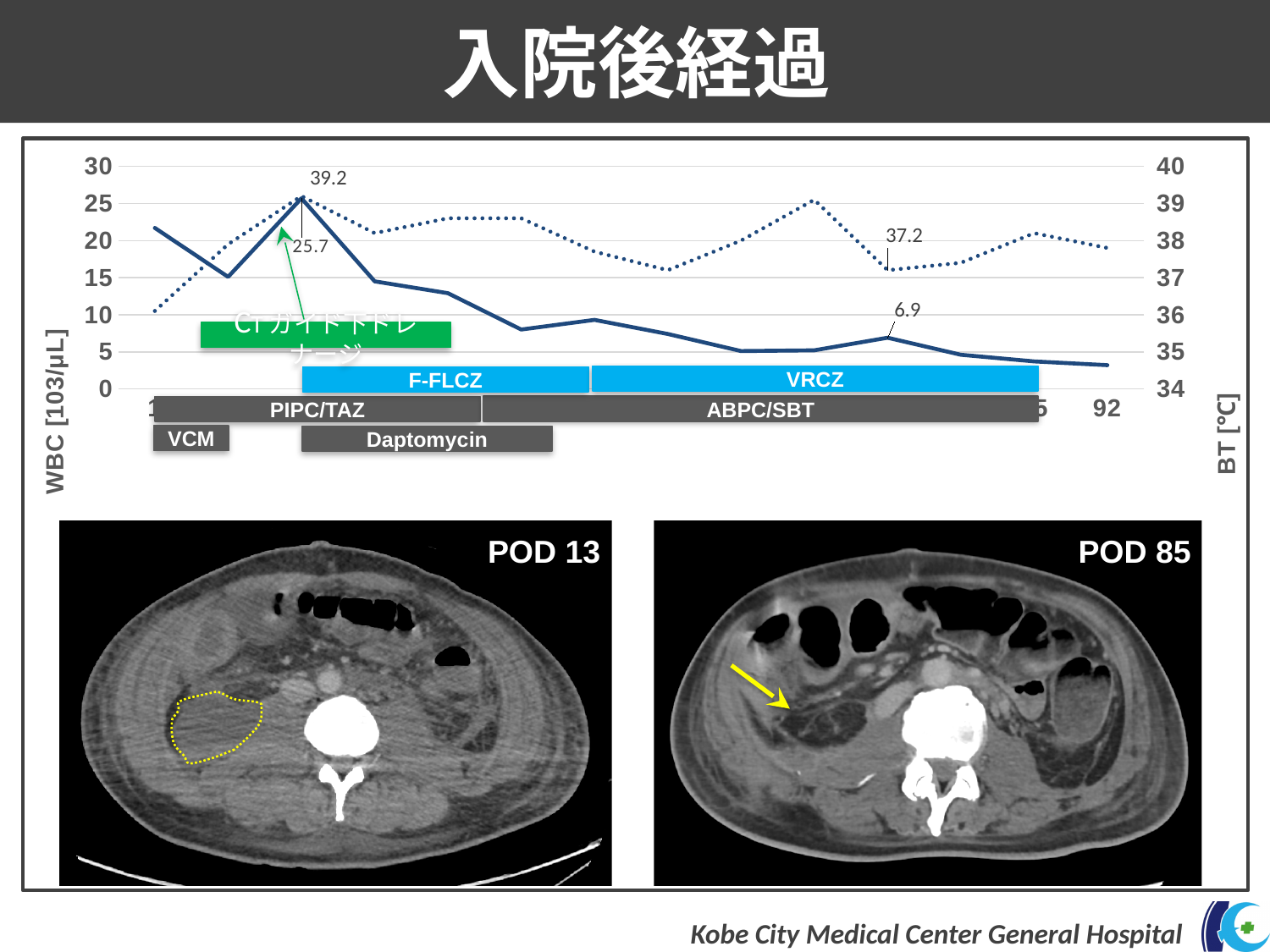
After its labeled peak of 25.7, does the WBC line generally rise or fall along the x axis? fall What is the difference between the two labeled WBC values, 25.7 and 6.9? 18.8 What is the labeled peak body temperature (BT) value on the chart? 39.2 Which labeled WBC value is larger, 25.7 or 6.9? 25.7 What kind of chart is used to show the WBC and BT course on the slide? line chart How many antimicrobial treatment bars are shown below the chart lines? 6 Is the final WBC value at the right end of the solid line greater or less than 5? less What is the later labeled BT value shown on the chart after the peak? 37.2 What is the labeled peak WBC value on the chart? 25.7 What is the difference between the two labeled BT values, 39.2 and 37.2? 2.0 What is the later labeled WBC value shown on the chart after the peak? 6.9 What is the maximum value shown on the right-hand BT axis? 40